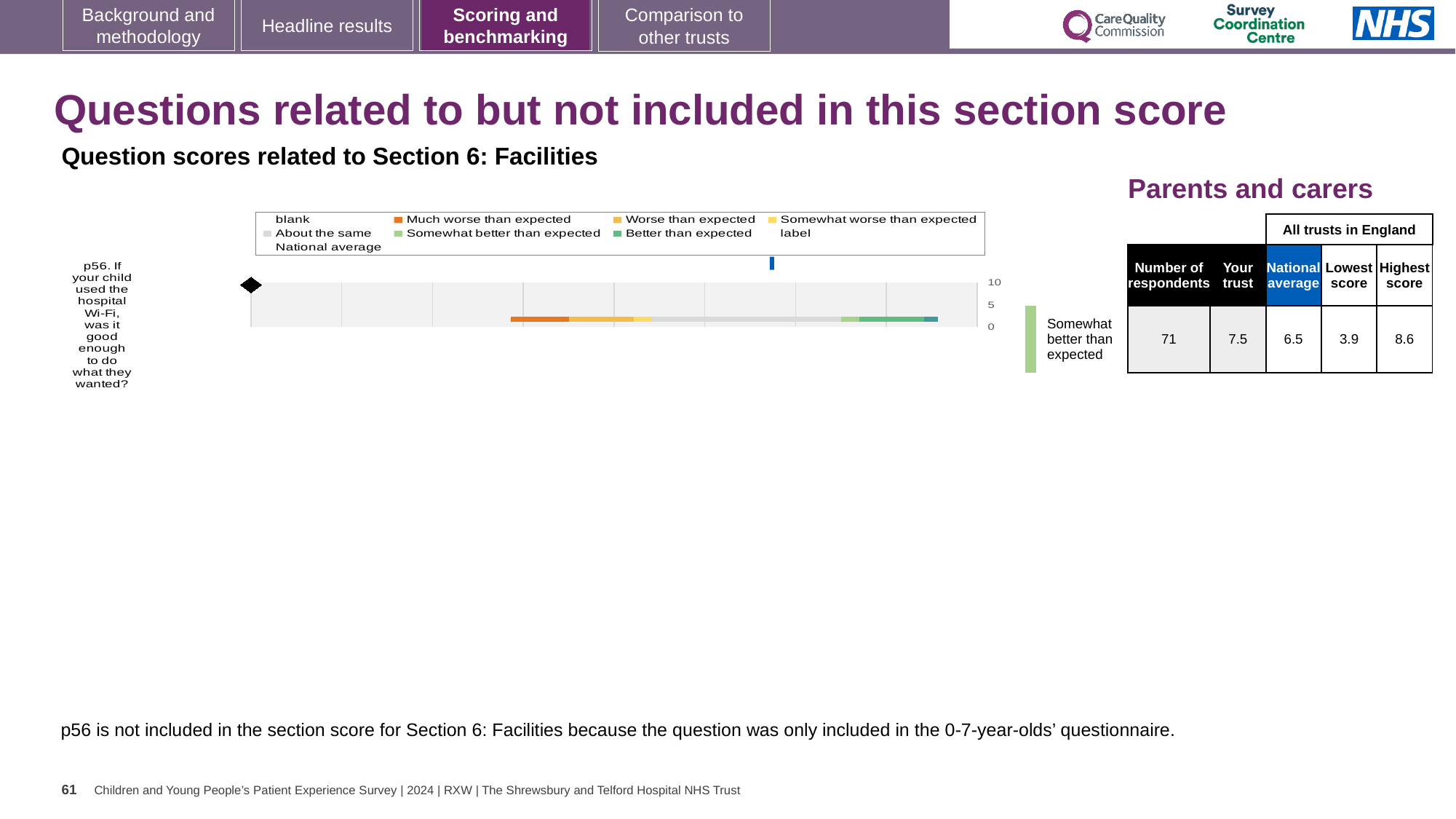
What is the difference between the highest score (8.6) and the lowest score (3.9) for p56? 4.7 What benchmark category is shown beside the chart for p56? Somewhat better than expected Which legend entry is shown in orange? Much worse than expected In the table beside the chart, what is the 'Your trust' score for p56? 7.5 Which is larger for p56: the 'Your trust' score or the national average? Your trust In the table beside the chart, what is the national average score for p56? 6.5 In the table beside the chart, what is the number of respondents for p56? 71 How many survey questions are plotted in the chart? 1 How many entries does the chart's legend list? 9 What is the highest tick value shown on the chart's axis? 10 What kind of chart is used to show the benchmarking result for p56? bar chart Which question number is plotted in the chart? p56